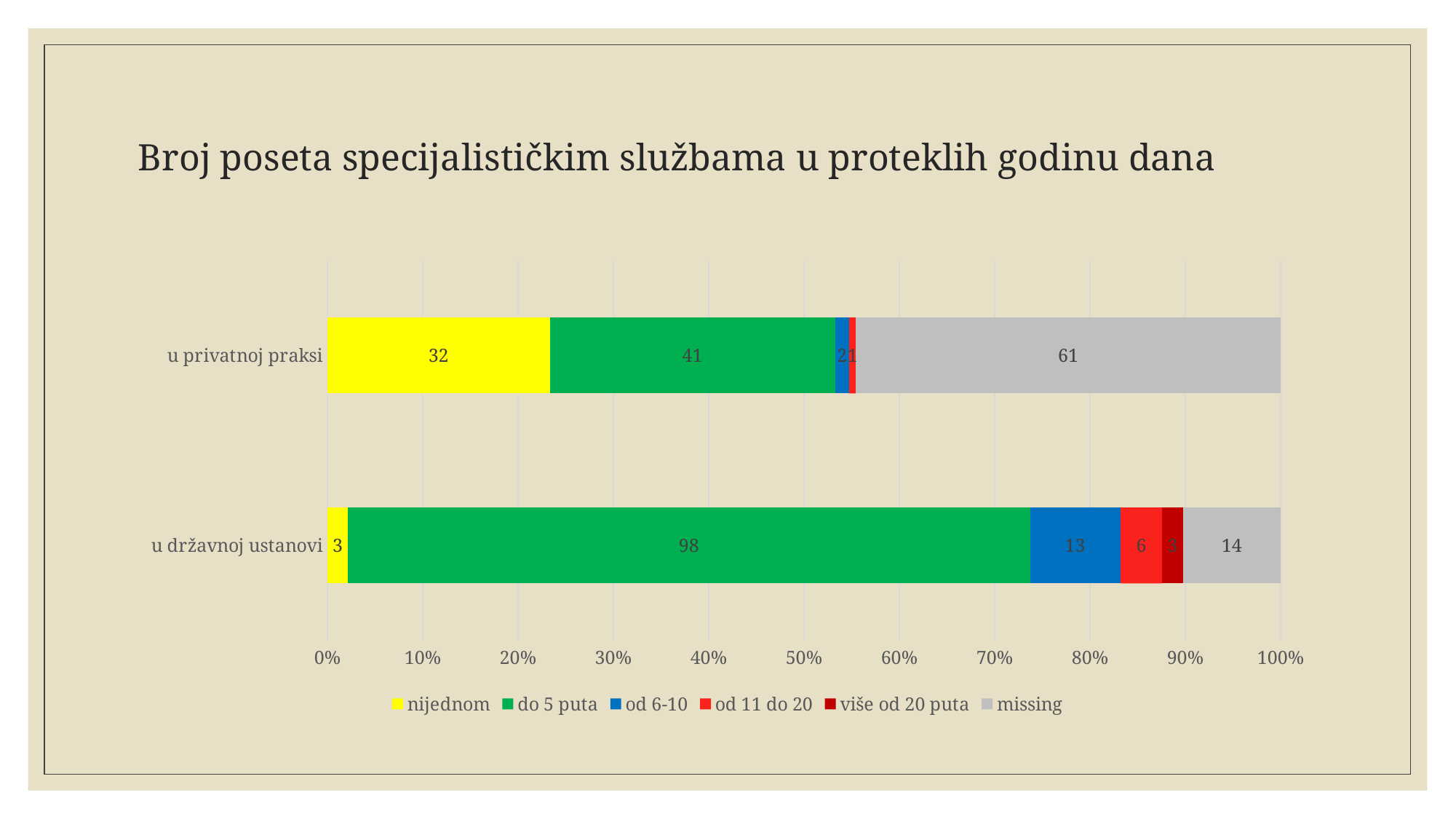
What is the total of all segments in the 'u državnoj ustanovi' bar? 137 What kind of chart is shown on the slide? bar chart What is the value of 'missing' for 'u privatnoj praksi'? 61 What is the difference between the 'do 5 puta' values for 'u državnoj ustanovi' and 'u privatnoj praksi'? 57 What is the value of 'od 11 do 20' for 'u državnoj ustanovi'? 6 What is the title of the chart? Broj poseta specijalističkim službama u proteklih godinu dana What is the value of 'od 6-10' for 'u državnoj ustanovi'? 13 How many categories are plotted on the vertical axis of the chart? 2 What is the value of 'nijednom' for 'u privatnoj praksi'? 32 How many series does the legend list? 6 Which category has the larger 'nijednom' value, 'u privatnoj praksi' or 'u državnoj ustanovi'? u privatnoj praksi What is the value of 'do 5 puta' for 'u državnoj ustanovi'? 98